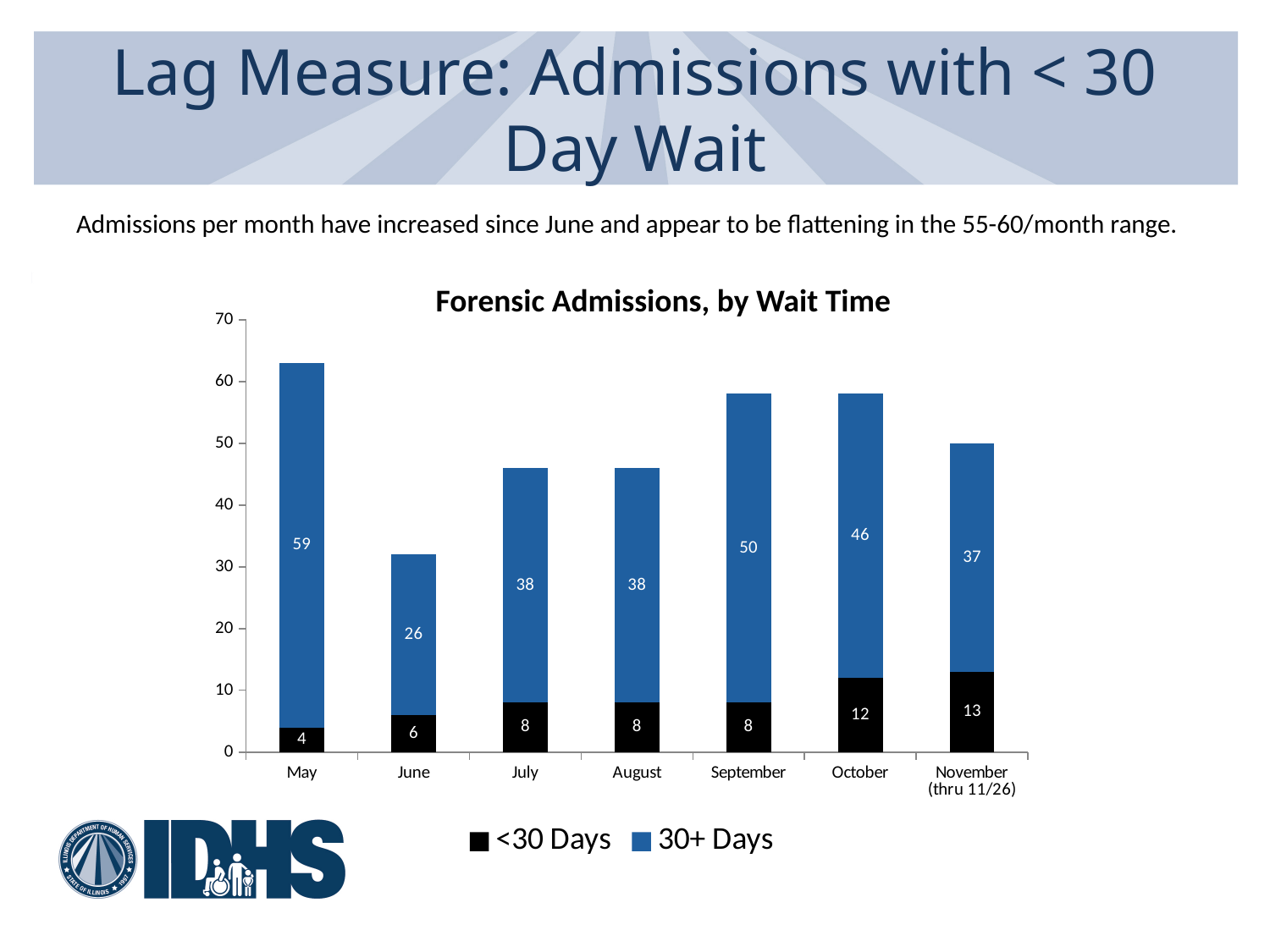
Which month has the highest value for 30+ Days? May How many series does the legend list? 2 Which month has the lowest value for <30 Days? May What is the total of the stacked bar for July? 46 What kind of chart is shown? Stacked bar chart What is the difference between the 30+ Days values for September and June? 24 What is the title of the chart? Forensic Admissions, by Wait Time Which is larger, the <30 Days value for November (thru 11/26) or for October? November (thru 11/26) What is the value for <30 Days in October? 12 How many months are shown on the x axis? 7 What is the total of the stacked bar for November (thru 11/26)? 50 What is the value for 30+ Days in May? 59